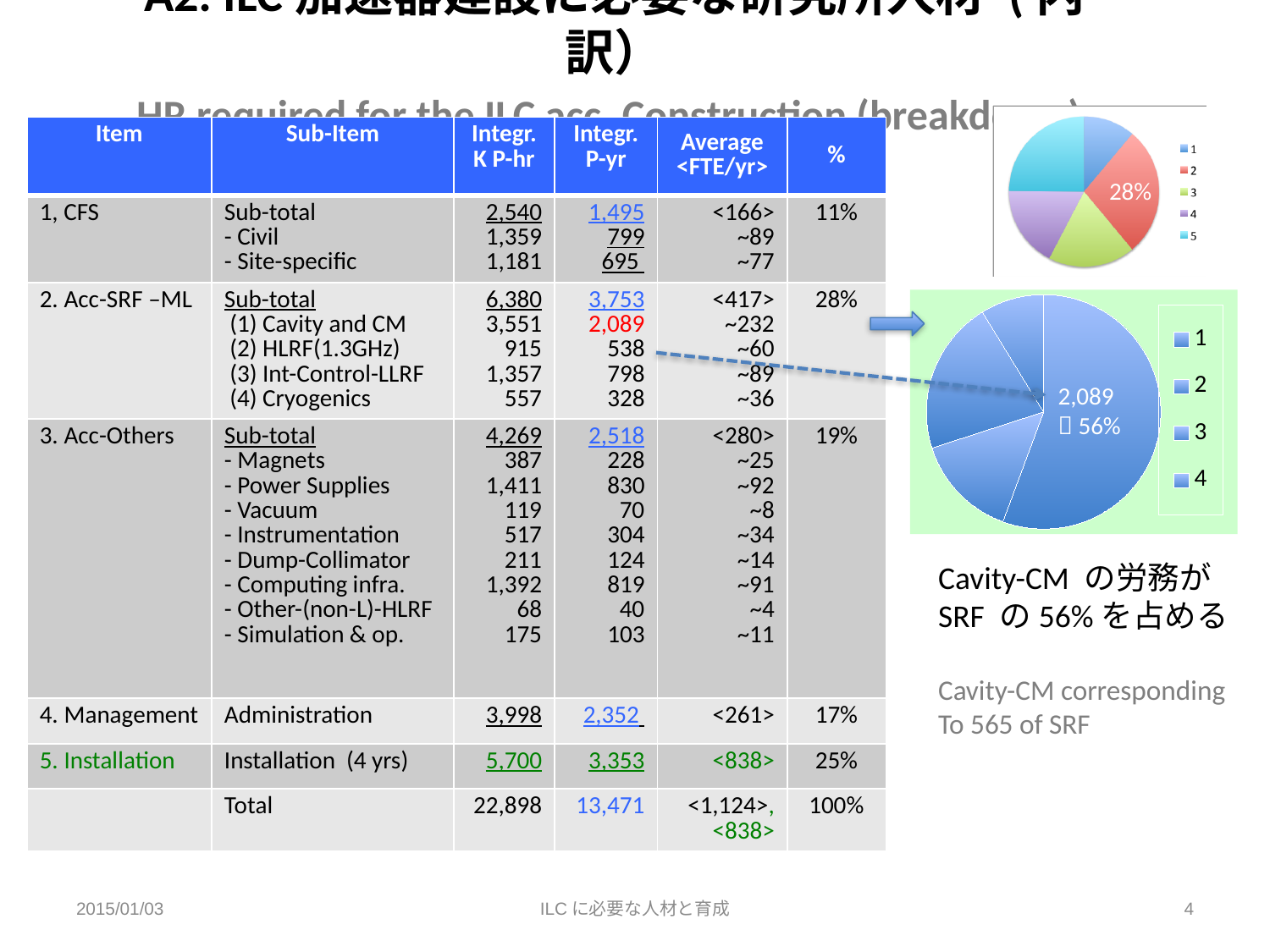
What kind of chart is shown in the top-right corner of the slide? pie chart In the top-right pie chart, what percentage is printed on the red slice? 28% In the pie chart on the green background, what value is printed on the largest slice? 2,089 In the pie chart on the green background, is the share of the largest slice greater or less than 50%? greater In the pie chart on the green background, how many slices does the pie have? 4 In the top-right pie chart, is the share of the red slice greater or less than 25%? greater In the top-right pie chart, how many slices does the pie have? 5 In the pie chart on the green background, how many entries does the legend list? 4 In the top-right pie chart, which legend entry is shown in red? 2 In the top-right pie chart, how many entries does the legend list? 5 In the pie chart on the green background, what share of the pie does the largest slice represent, according to its label? 56% What kind of chart is shown on the green background on the right side of the slide? pie chart